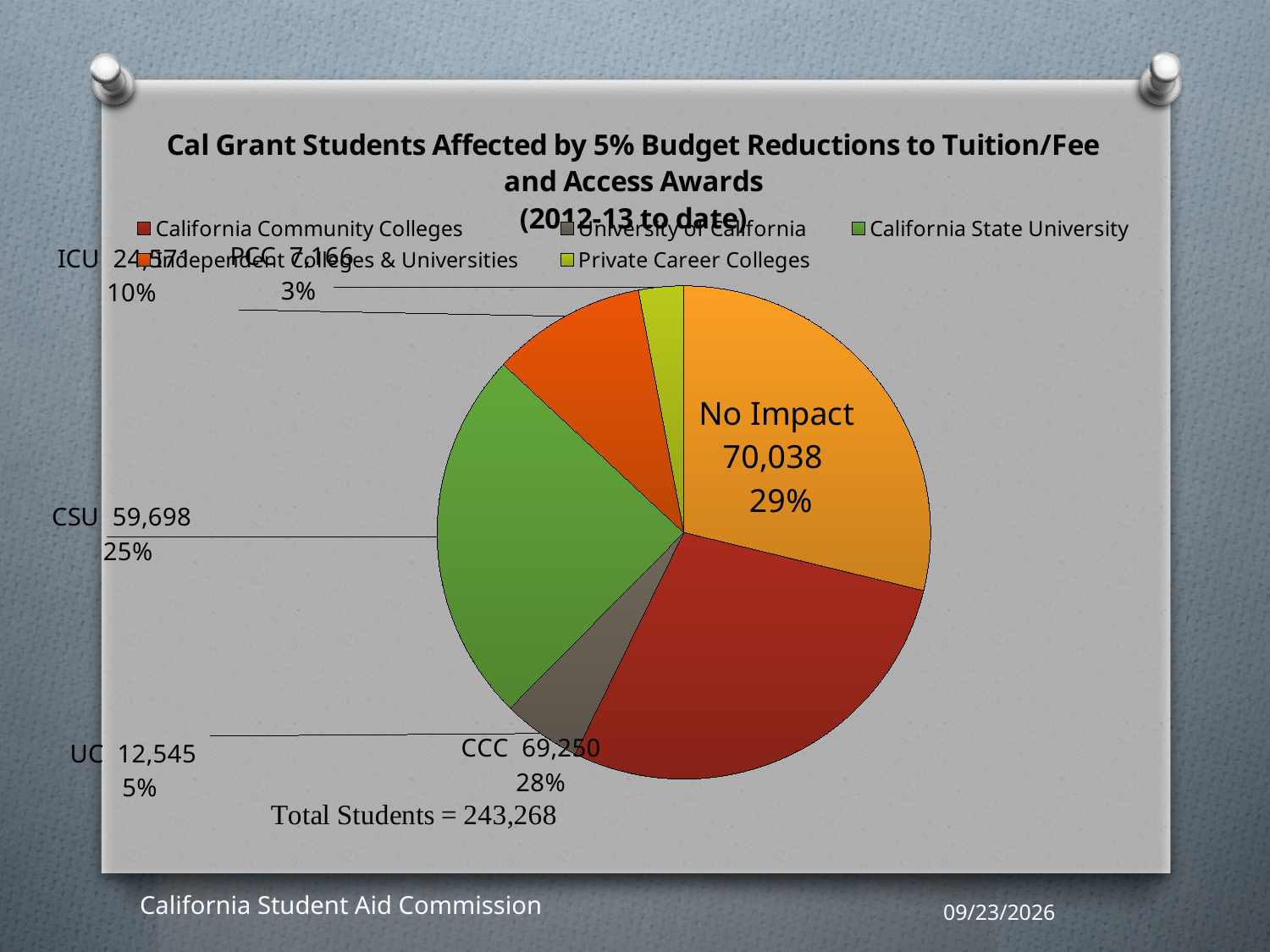
What share of the pie does PCC represent? 3% How many students are in the UC slice? 12,545 What kind of chart is shown on the slide? pie chart How many students are in the CCC slice? 69,250 Which slice of the pie is the largest? No Impact What is the difference in students between the No Impact slice and the CCC slice? 788 Which slice has more students, CSU or UC? CSU What share of the pie does CSU represent? 25% Which slice of the pie is the smallest? PCC How many students are in the No Impact slice? 70,038 How many slices does the pie chart have? 6 What is the total number of students stated below the pie chart? 243,268